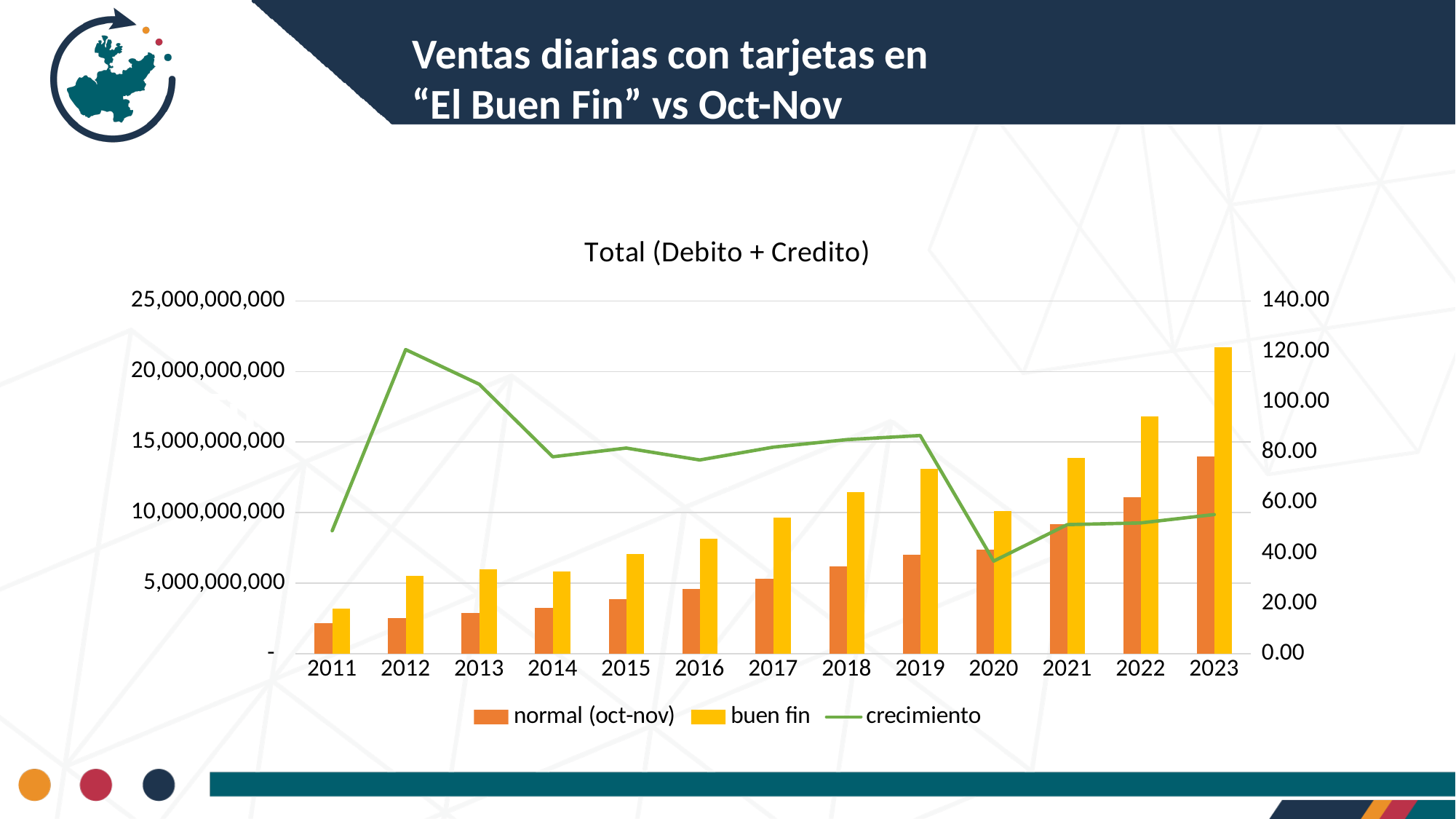
Is the 'crecimiento' value for 2012 greater or less than 100.00? greater Which series is drawn as a line in the chart? crecimiento What is the title of the chart? Total (Debito + Credito) In which year does the 'crecimiento' line reach its highest point? 2012 In 2023, which is larger: the 'normal (oct-nov)' bar or the 'buen fin' bar? buen fin In which year is the 'buen fin' bar the lowest? 2011 In which year is the 'buen fin' bar the highest? 2023 Is the 'buen fin' value for 2023 greater or less than 20,000,000,000? greater In which year does the 'crecimiento' line reach its lowest point? 2020 What kind of chart is shown on the slide? A combined bar and line chart How many series does the chart legend list? 3 How many years are shown on the x axis of the chart? 13